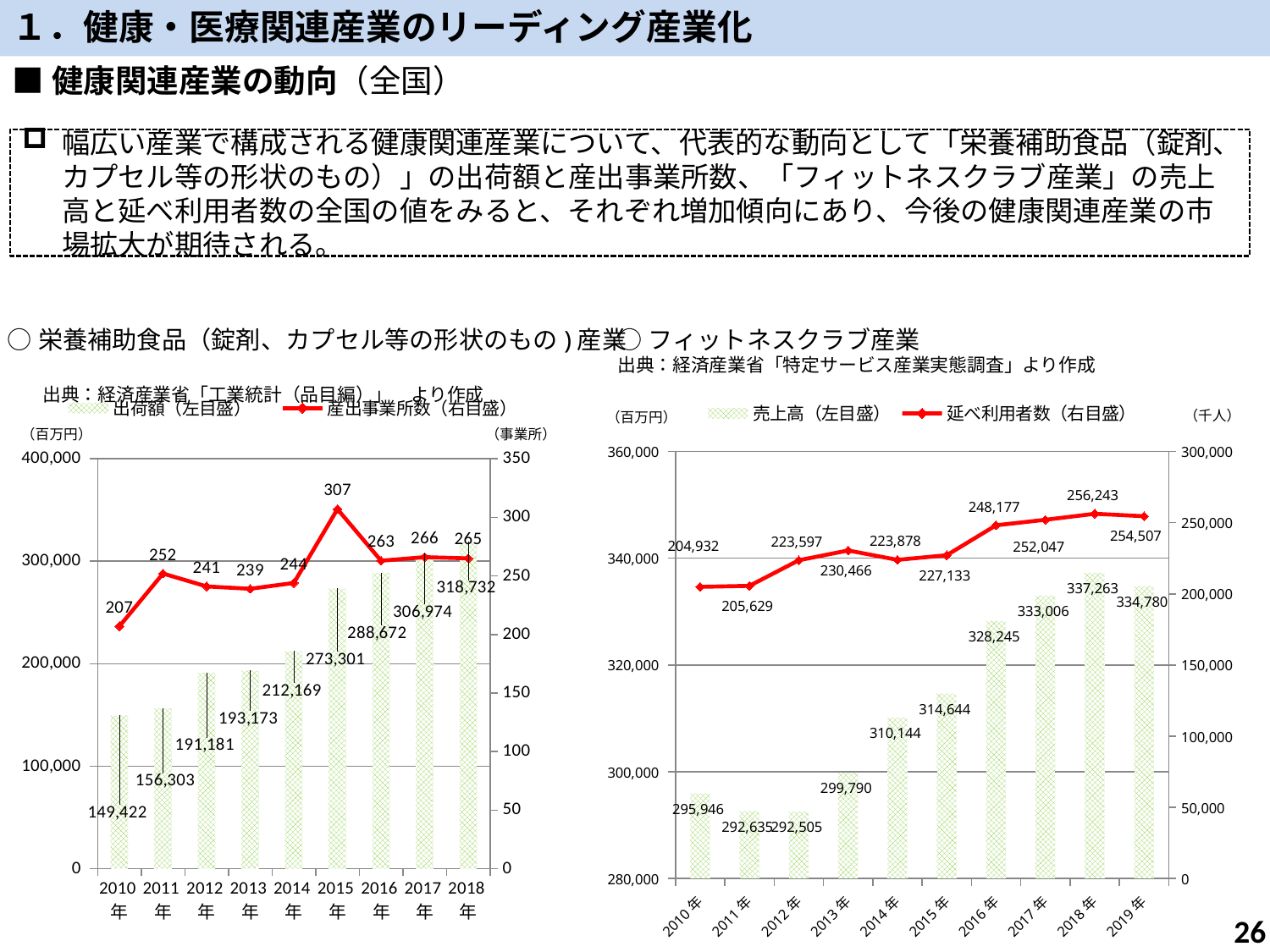
In the フィットネスクラブ産業 chart on the right, how many years are shown on the x axis? 10 In the 栄養補助食品 chart on the left, what is the difference in 出荷額 between 2018年 and 2017年? 11,758 In the 栄養補助食品 chart on the left, what is the 出荷額 value for 2015年? 273,301 In the フィットネスクラブ産業 chart on the right, which is larger, the 延べ利用者数 for 2013年 or for 2014年? 2013年 In the 栄養補助食品 chart on the left, which year has the highest 産出事業所数? 2015年 In the フィットネスクラブ産業 chart on the right, what is the difference in 延べ利用者数 between 2019年 and 2010年? 49,575 In the 栄養補助食品 chart on the left, how many series does the legend list? 2 In the 栄養補助食品 chart on the left, which year has the lowest 出荷額? 2010年 In the フィットネスクラブ産業 chart on the right, what is the 売上高 value for 2016年? 328,245 In the 栄養補助食品 chart on the left, what is the 産出事業所数 value for 2010年? 207 In the フィットネスクラブ産業 chart on the right, what is the 延べ利用者数 value for 2018年? 256,243 In the フィットネスクラブ産業 chart on the right, which year has the lowest 売上高? 2012年